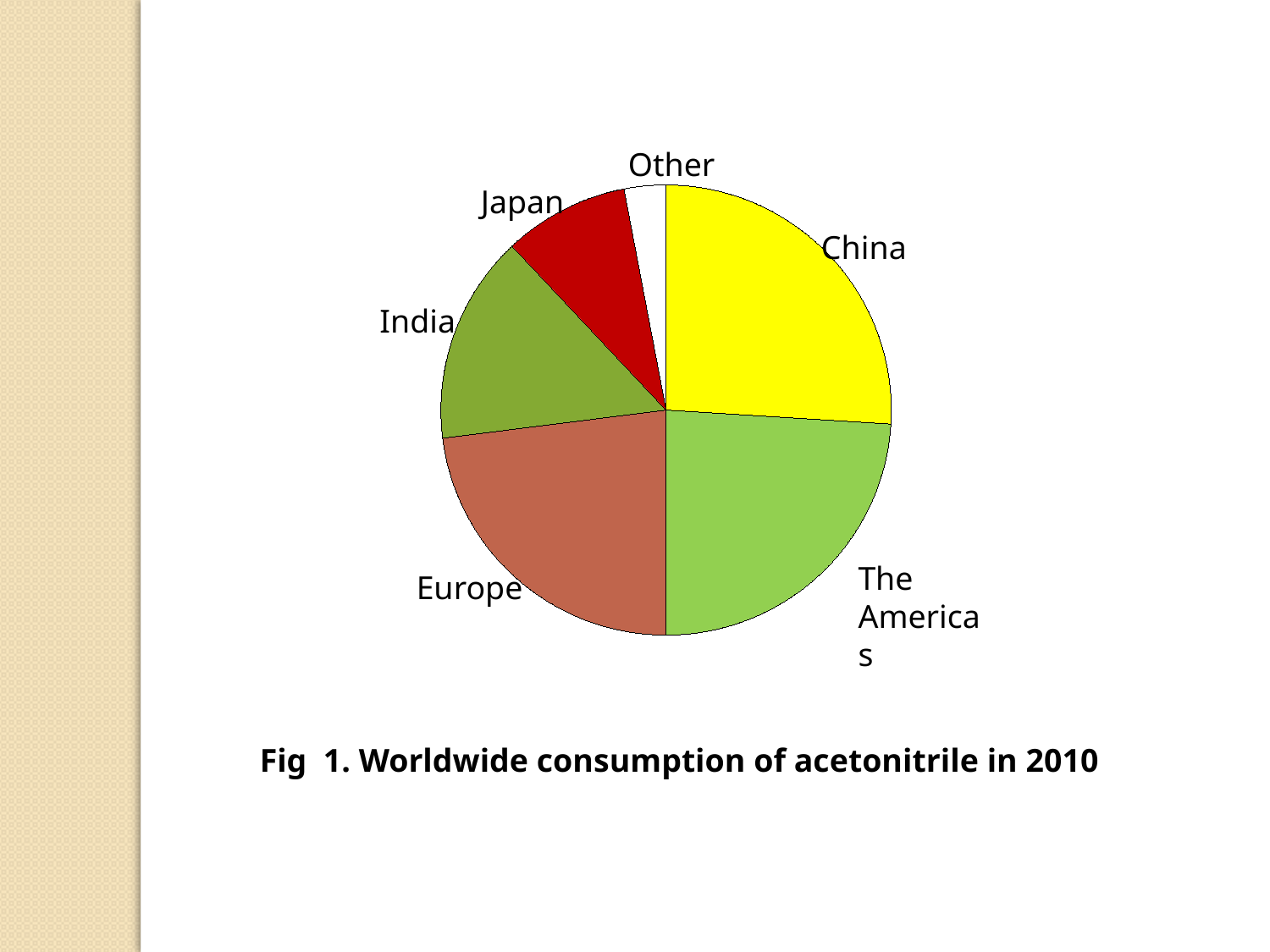
What colour is the China slice in the pie chart? Yellow Which slice is larger, India or Japan? India Which slice is larger, The Americas or India? The Americas Which slice is larger, Europe or Japan? Europe What kind of chart is shown on the slide? Pie chart How many slices does the pie chart have? 6 Which region has the smallest slice of the pie chart? Other What is the caption of the pie chart? Fig 1. Worldwide consumption of acetonitrile in 2010